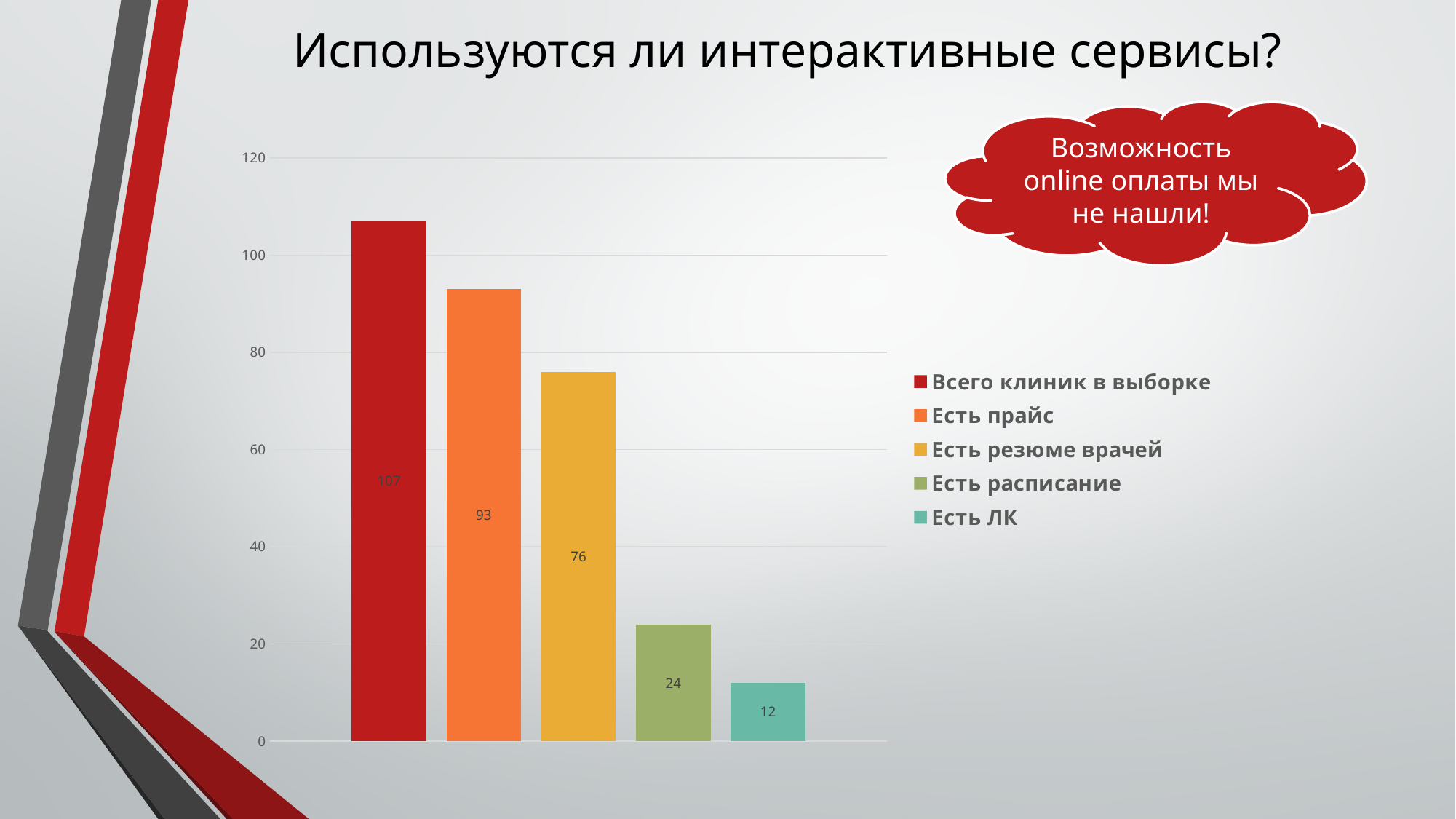
What is the value for "Есть расписание"? 24 Which is larger, "Есть резюме врачей" or "Есть расписание"? Есть резюме врачей How many series does the legend list? 5 What kind of chart is shown on the slide? Bar chart Which series has the lowest value? Есть ЛК What is the value for "Есть резюме врачей"? 76 What is the difference between "Есть расписание" and "Есть ЛК"? 12 What is the difference between "Всего клиник в выборке" and "Есть прайс"? 14 Which series has the highest value? Всего клиник в выборке What is the value for "Есть ЛК"? 12 What is the value for "Есть прайс"? 93 What is the value for "Всего клиник в выборке"? 107